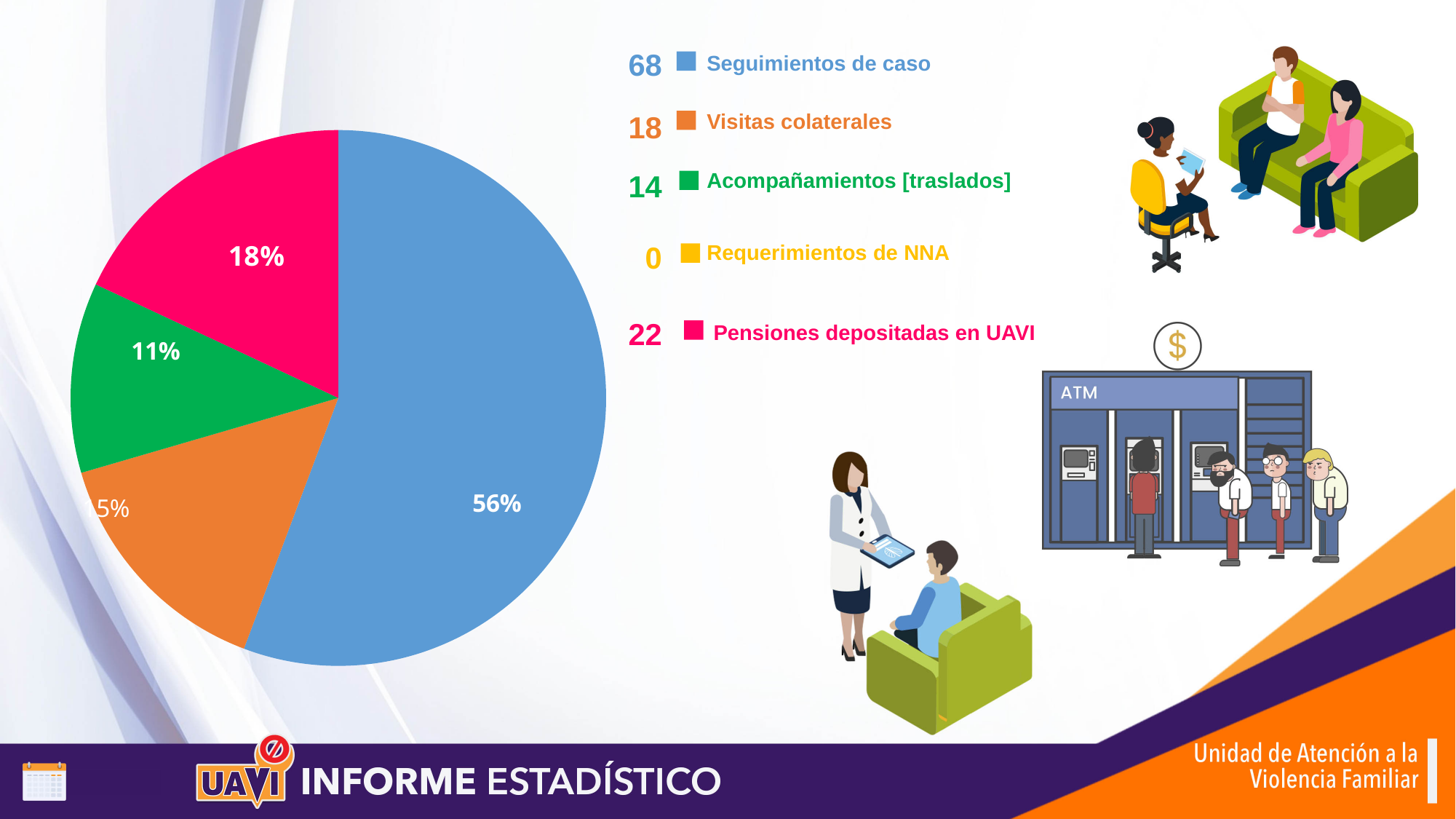
What is the count shown in the legend for Requerimientos de NNA? 0 How many entries does the legend list? 5 Which category has the largest slice of the pie? Seguimientos de caso What share of the pie does the Pensiones depositadas en UAVI slice represent? 18% Which category has the smallest visible slice of the pie? Acompañamientos [traslados] Which slice is larger, Visitas colaterales or Pensiones depositadas en UAVI? Pensiones depositadas en UAVI What share of the pie does the Acompañamientos [traslados] slice represent? 11% What share of the pie does the Visitas colaterales slice represent? 15% What is the difference in percentage points between the Seguimientos de caso slice and the Pensiones depositadas en UAVI slice? 38 percentage points What kind of chart is shown on the slide? pie chart What is the count shown in the legend for Seguimientos de caso? 68